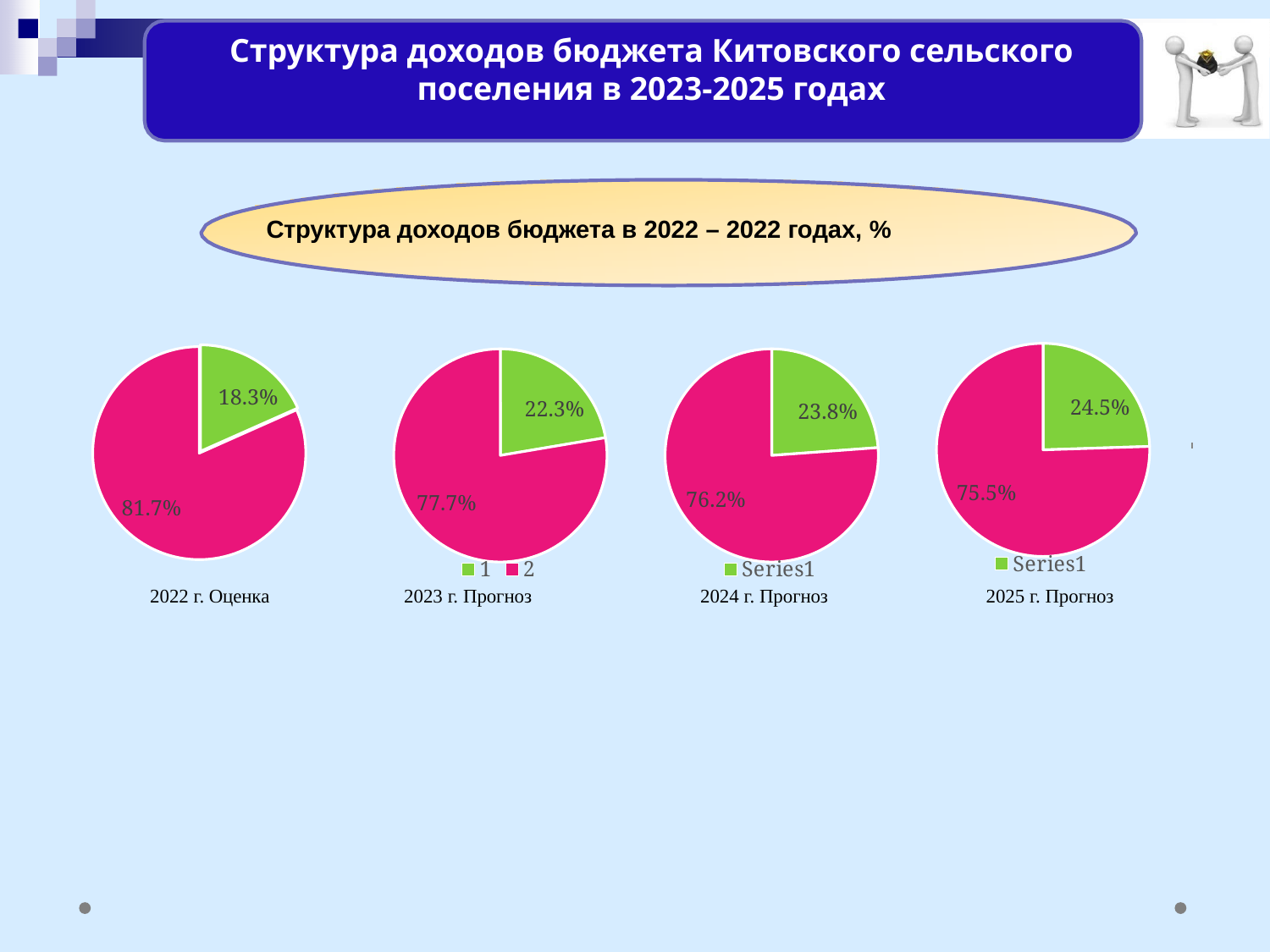
What entries does the legend of the pie chart labelled "2023 г. Прогноз" list? 1 and 2 How many pie charts are shown on the slide? 4 In the pie chart labelled "2022 г. Оценка", what value is shown for the pink slice? 81.7% What kind of charts are shown on the slide? pie charts Does the green slice's share rise or fall from the 2022 chart to the 2025 chart? rise In the pie chart labelled "2024 г. Прогноз", which slice is larger, the green one or the pink one? the pink one In the pie chart labelled "2025 г. Прогноз", what value is shown for the green slice? 24.5% In the pie chart labelled "2022 г. Оценка", what value is shown for the green slice? 18.3% In the pie chart labelled "2024 г. Прогноз", what value is shown for the pink slice? 76.2% In the pie chart labelled "2023 г. Прогноз", what is the difference between the pink slice and the green slice? 55.4% In the pie chart labelled "2023 г. Прогноз", what value is shown for the green slice? 22.3% In the pie chart labelled "2025 г. Прогноз", what value is shown for the pink slice? 75.5%